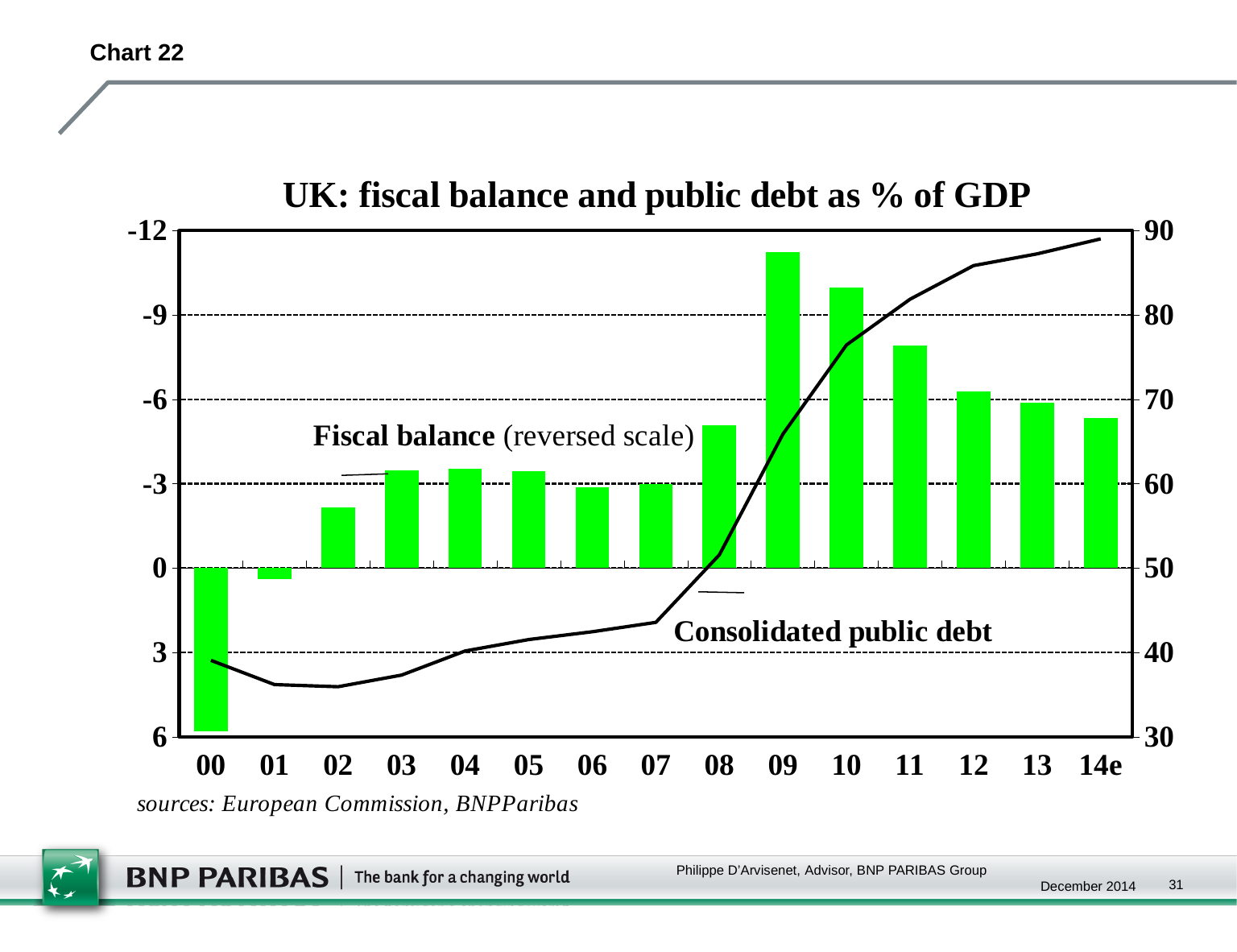
What kind of chart is shown on the slide? A combined bar and line chart In which year does the fiscal balance bar reach its largest deficit (tallest bar above the zero line)? 09 Which series is plotted as a line in the chart? Consolidated public debt Is the consolidated public debt value for 02 greater or less than 40? less Is the consolidated public debt value for 14e greater or less than 80? greater Is the consolidated public debt value for 10 greater or less than 70? greater How many years are shown along the x axis of the chart? 15 How many data series are labelled on the chart? 2 What is the title of the chart? UK: fiscal balance and public debt as % of GDP Which year shows a larger fiscal deficit bar, 09 or 10? 09 Does the consolidated public debt line rise or fall between 08 and 14e? Rise